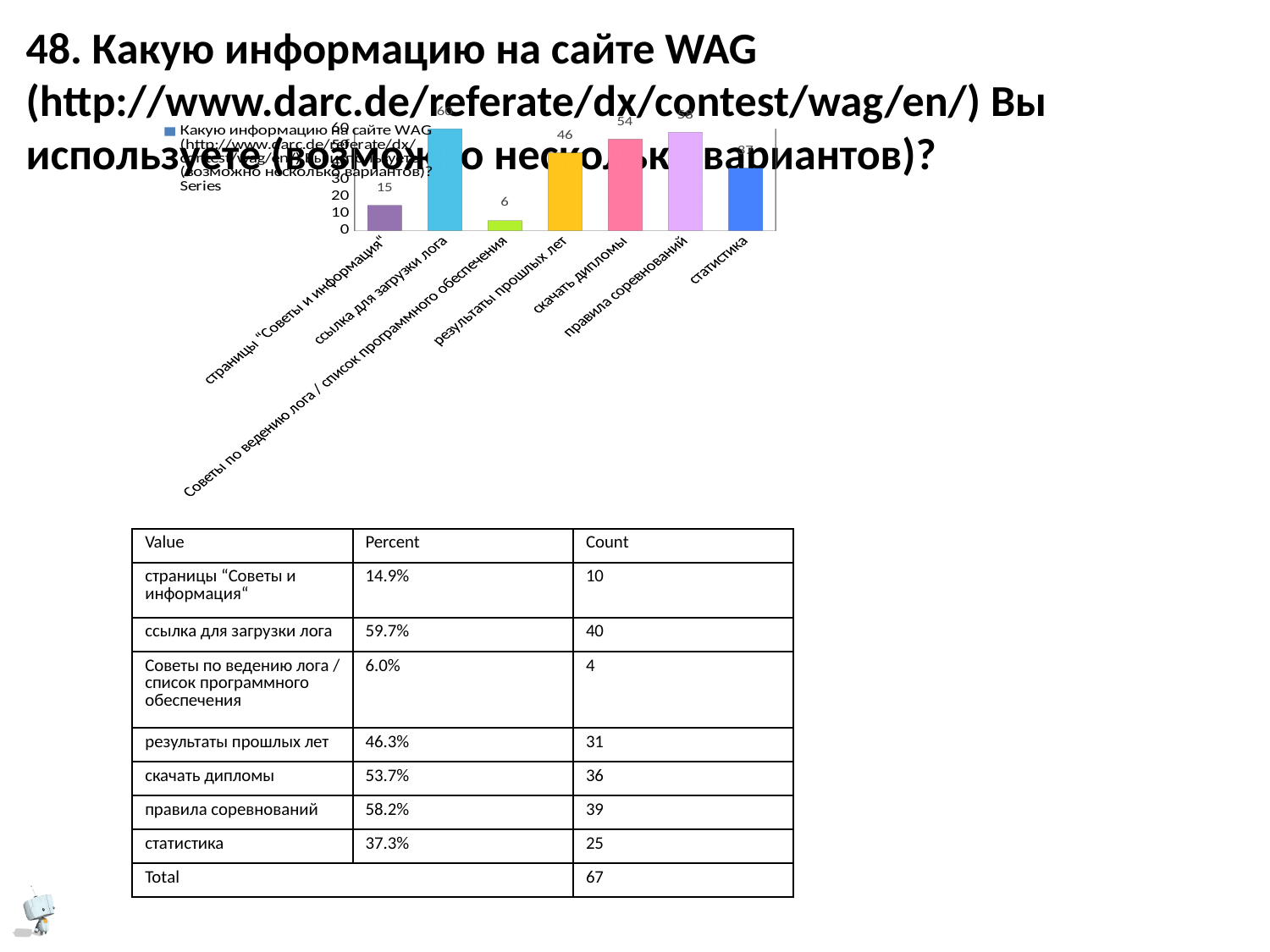
What is the value shown for "страницы "Советы и информация""? 15 Which category has the lowest value in the chart? Советы по ведению лога / список программного обеспечения Which is larger: the value for "скачать дипломы" or the value for "результаты прошлых лет"? скачать дипломы What is the value shown for "Советы по ведению лога / список программного обеспечения"? 6 How many categories are shown in the chart? 7 What is the value shown for "скачать дипломы"? 54 Is the value for "ссылка для загрузки лога" greater or less than 50? greater What is the difference between the values for "скачать дипломы" and "результаты прошлых лет"? 8 What kind of chart is shown on the slide? bar chart What is the value shown for "результаты прошлых лет"? 46 Is the value for "статистика" greater or less than 30? greater How many series does the legend list? 1